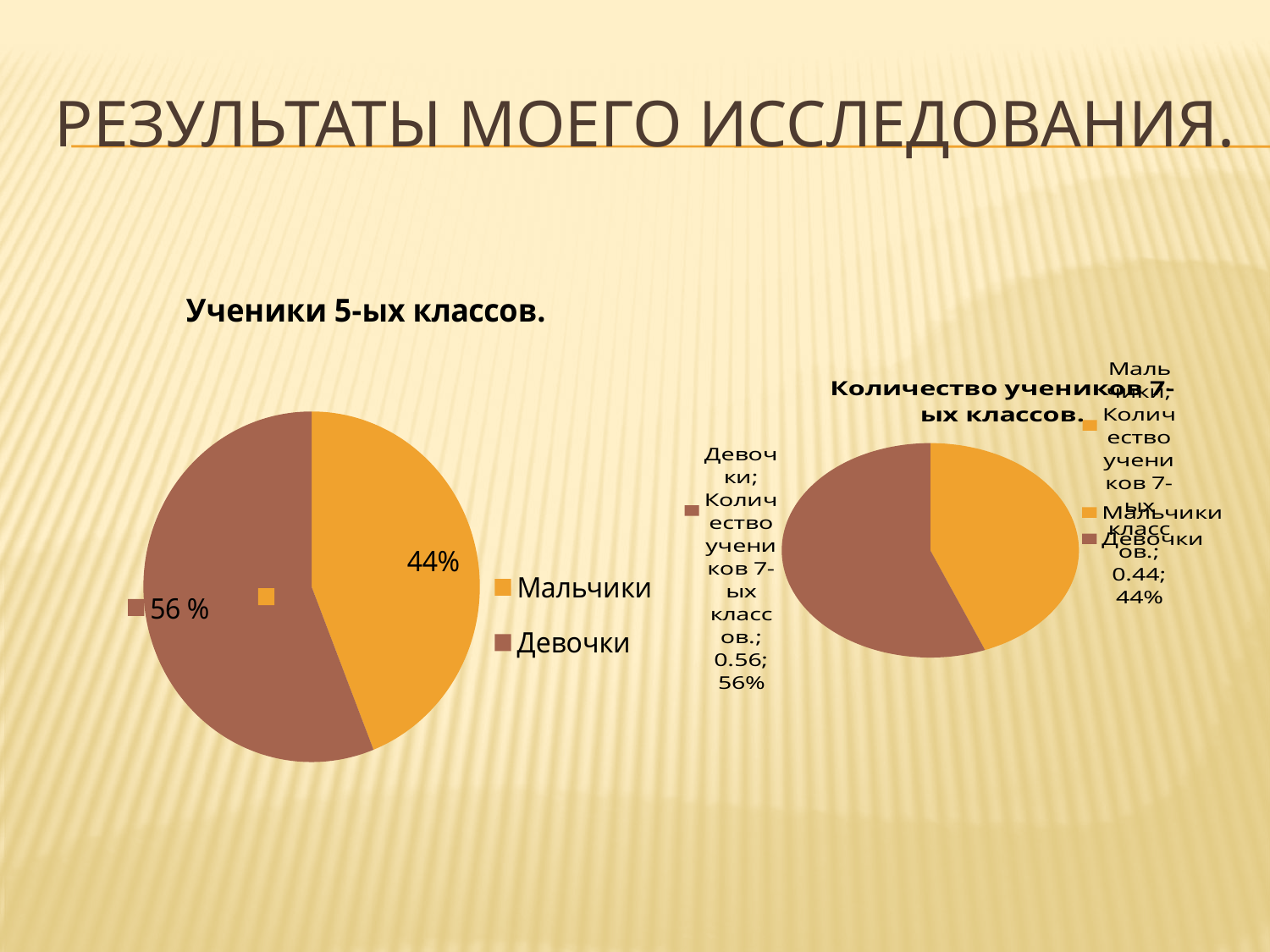
In the chart titled "Количество учеников 7-ых классов.", what percentage is shown for Мальчики? 44% In the chart titled "Ученики 5-ых классов.", what share is shown for Мальчики? 44% In the chart titled "Количество учеников 7-ых классов.", which is larger, Мальчики or Девочки? Девочки In the chart titled "Ученики 5-ых классов.", what share is shown for Девочки? 56 % How many entries does the legend of the chart titled "Ученики 5-ых классов." list? 2 How many slices does the chart titled "Ученики 5-ых классов." have? 2 In the chart titled "Ученики 5-ых классов.", by how many percentage points does Девочки exceed Мальчики? 12 What kind of chart is the chart titled "Ученики 5-ых классов."? pie chart In the chart titled "Количество учеников 7-ых классов.", what percentage is shown for Девочки? 56% In the chart titled "Ученики 5-ых классов.", which category has the smallest slice? Мальчики In the chart titled "Ученики 5-ых классов.", what colour is the Мальчики slice? orange In the chart titled "Ученики 5-ых классов.", which category has the largest slice? Девочки